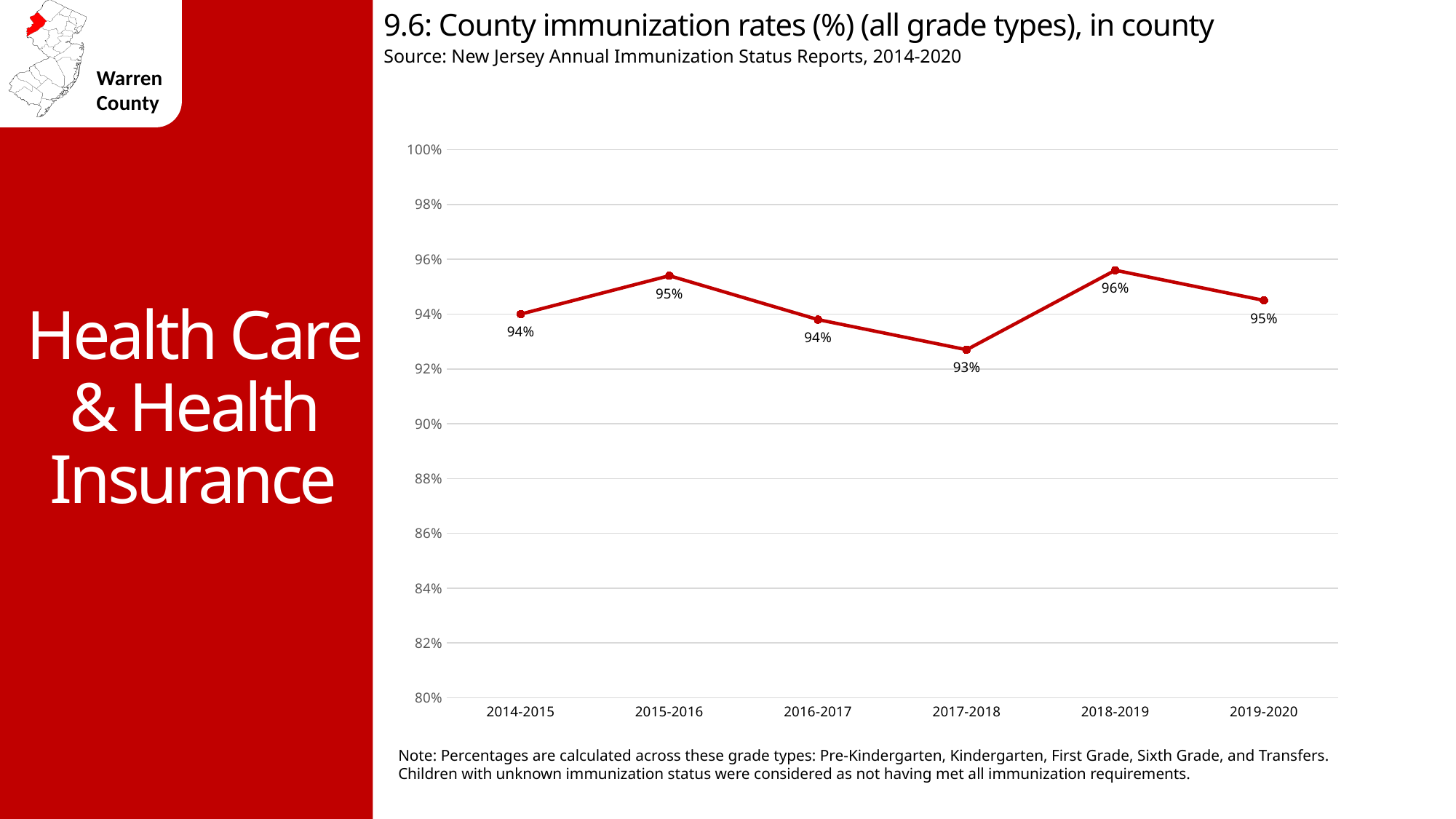
What is the difference in percentage points between the 2018-2019 rate and the 2017-2018 rate? 3 percentage points Is the value for 2017-2018 greater or less than 92%? greater What was the county immunization rate in 2018-2019? 96% Did the immunization rate rise or fall from 2017-2018 to 2018-2019? Rise How many school years are plotted on the chart? 6 Which year had a higher immunization rate, 2015-2016 or 2017-2018? 2015-2016 Which school year had the highest immunization rate? 2018-2019 What kind of chart is shown on the slide? Line chart What was the county immunization rate in 2017-2018? 93% What was the county immunization rate in 2014-2015? 94% Which school year had the lowest immunization rate? 2017-2018 What is the source cited for the chart? New Jersey Annual Immunization Status Reports, 2014-2020